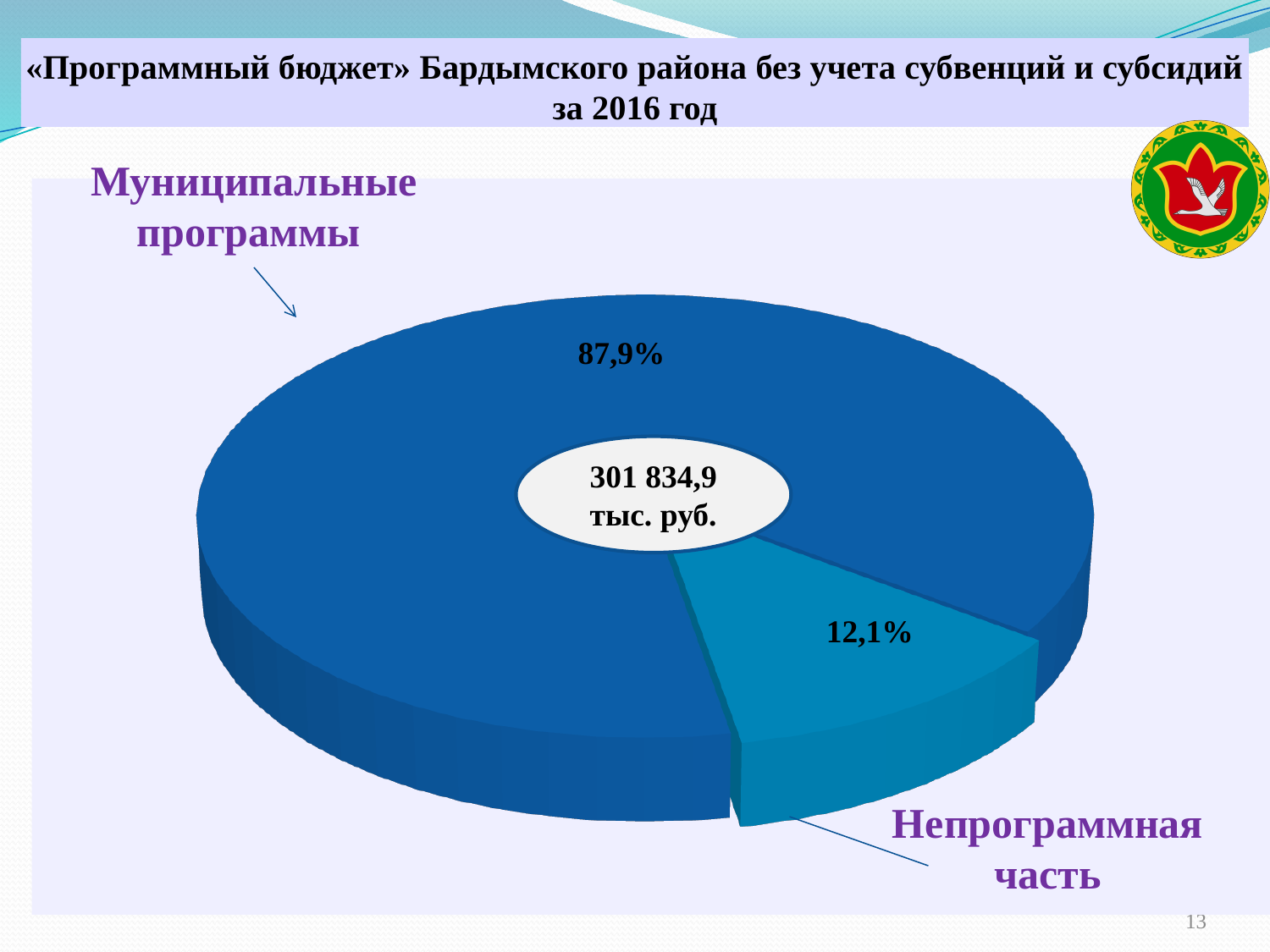
Which slice of the pie is the largest? Муниципальные программы How many slices does the pie chart have? 2 What total amount is shown in the centre of the pie chart? 301 834,9 тыс. руб. What share of the pie does «Непрограммная часть» take? 12,1% What share of the pie does «Муниципальные программы» take? 87,9% Which is larger: the share of «Муниципальные программы» or the share of «Непрограммная часть»? Муниципальные программы What is the title of the slide containing the pie chart? «Программный бюджет» Бардымского района без учета субвенций и субсидий за 2016 год What is the difference in percentage points between «Муниципальные программы» and «Непрограммная часть»? 75,8 Which slice of the pie is the smallest? Непрограммная часть Which year does the pie chart refer to? 2016 What kind of chart is shown on the slide? Pie chart